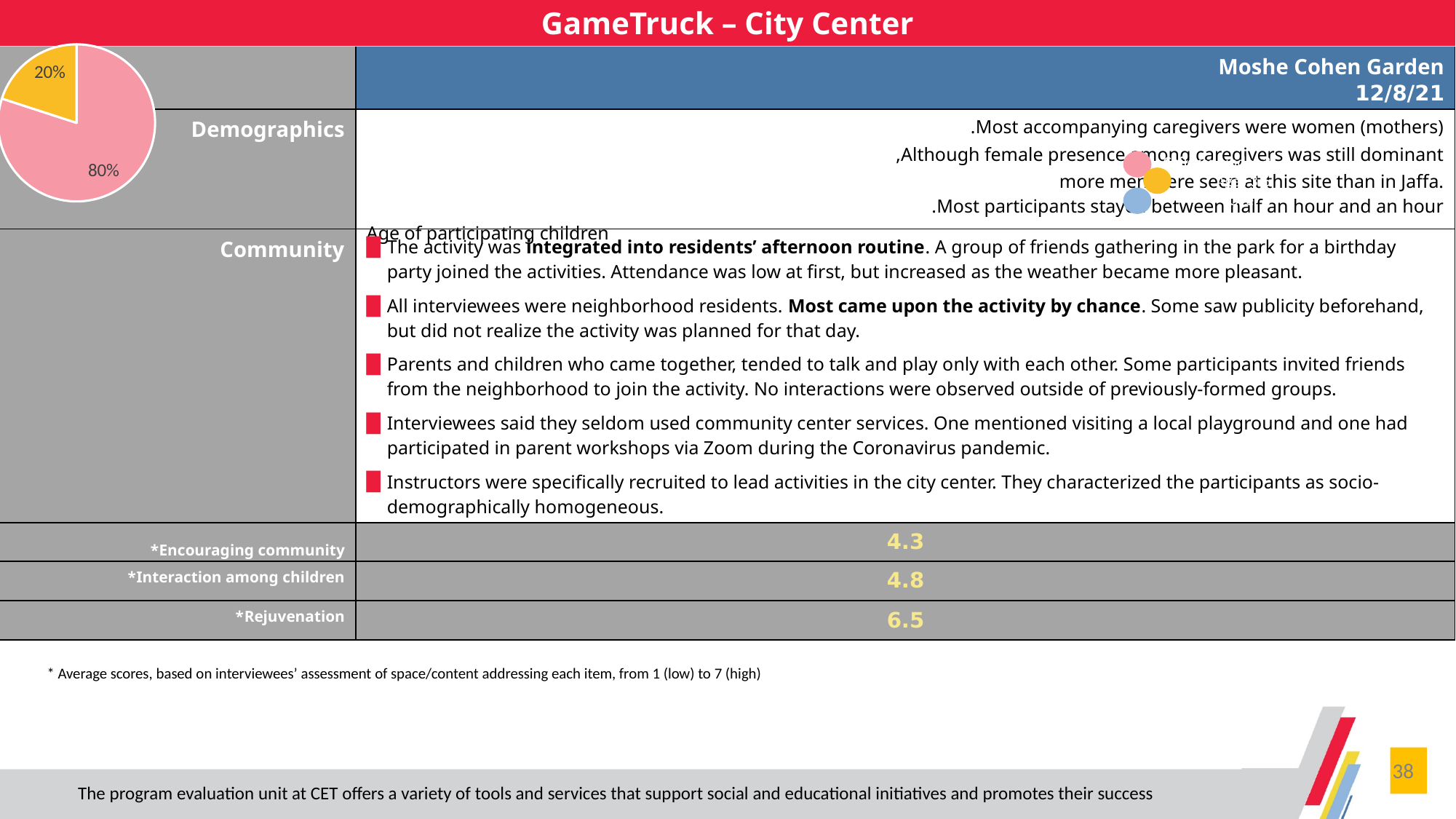
What is the difference between the two slices of the pie chart? 60% Is the value of the smaller slice of the pie chart greater or less than 50%? less What share of the pie chart does the pink slice represent? 80% What share of the pie chart does the yellow slice represent? 20% What is the title printed beneath the pie chart? Age of participating children What kind of chart is shown in the top-left corner of the slide? pie chart Which slice of the pie chart is larger, the one labelled 80% or the one labelled 20%? 80% What is the largest value shown on the pie chart? 80% How many slices does the pie chart have? 2 What is the smallest value shown on the pie chart? 20%